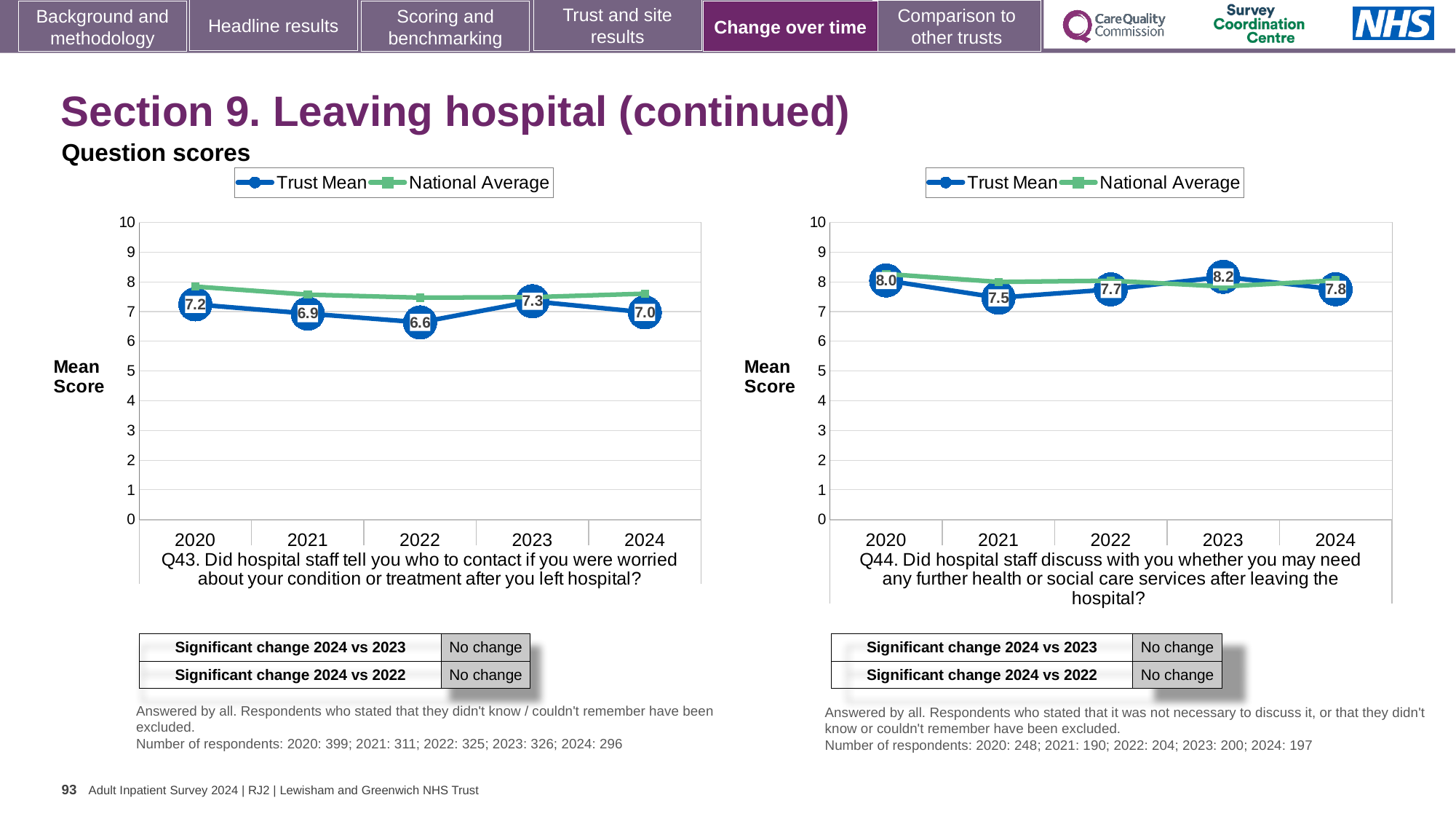
In the Q43 chart on the left, what is the difference between the Trust Mean scores for 2023 and 2022? 0.7 What kind of chart is the Q44 chart on the right? Line chart In the Q43 chart on the left, which year has the lowest Trust Mean score? 2022 In the Q43 chart on the left, what is the Trust Mean score for 2024? 7.0 In the Q43 chart on the left, what is the Trust Mean score for 2022? 6.6 In the Q43 chart on the left, is the National Average value for 2020 greater or less than 7? greater In the Q44 chart on the right, which is larger, the Trust Mean score for 2020 or for 2024? 2020 In the Q44 chart on the right, which year has the highest Trust Mean score? 2023 In the Q44 chart on the right, what is the Trust Mean score for 2021? 7.5 How many series does the legend of the Q43 chart on the left list? 2 How many years are plotted on the x axis of the Q44 chart on the right? 5 In the Q43 chart on the left, does the Trust Mean score rise or fall from 2023 to 2024? Fall